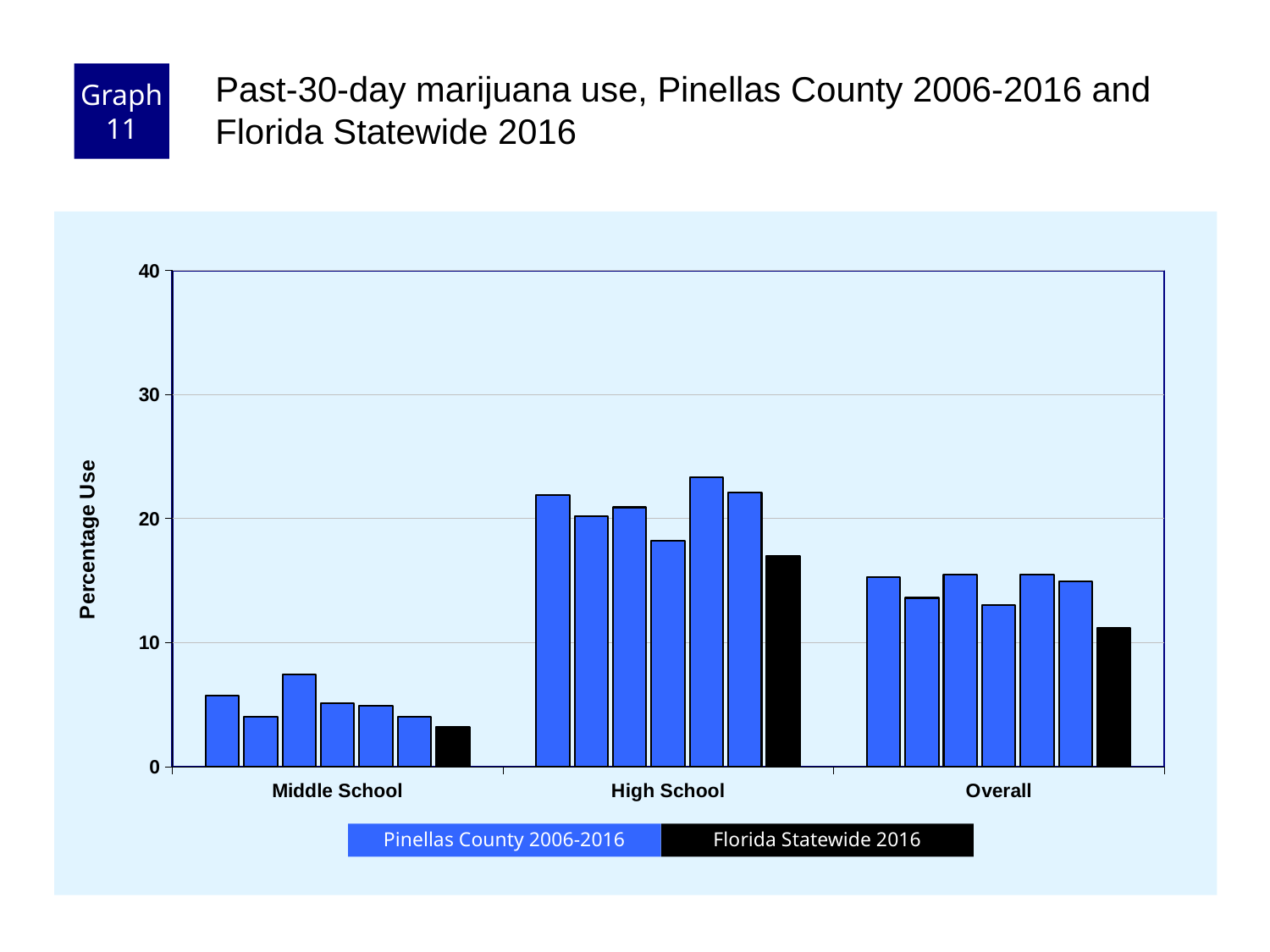
How many categories are shown on the x axis? 3 What is the label of the y axis? Percentage Use Are the Pinellas County 2006-2016 values for High School greater or less than 30? less Is the Florida Statewide 2016 value for Middle School greater or less than 10? less Which category has the highest values for past-30-day marijuana use? High School Is the Florida Statewide 2016 value for High School greater or less than 20? less Which is larger, the Florida Statewide 2016 value for High School or for Overall? High School How many series does the legend list? 2 What kind of chart is shown on the slide? bar chart Which series is shown in black in the legend? Florida Statewide 2016 Which category has the lowest values for past-30-day marijuana use? Middle School